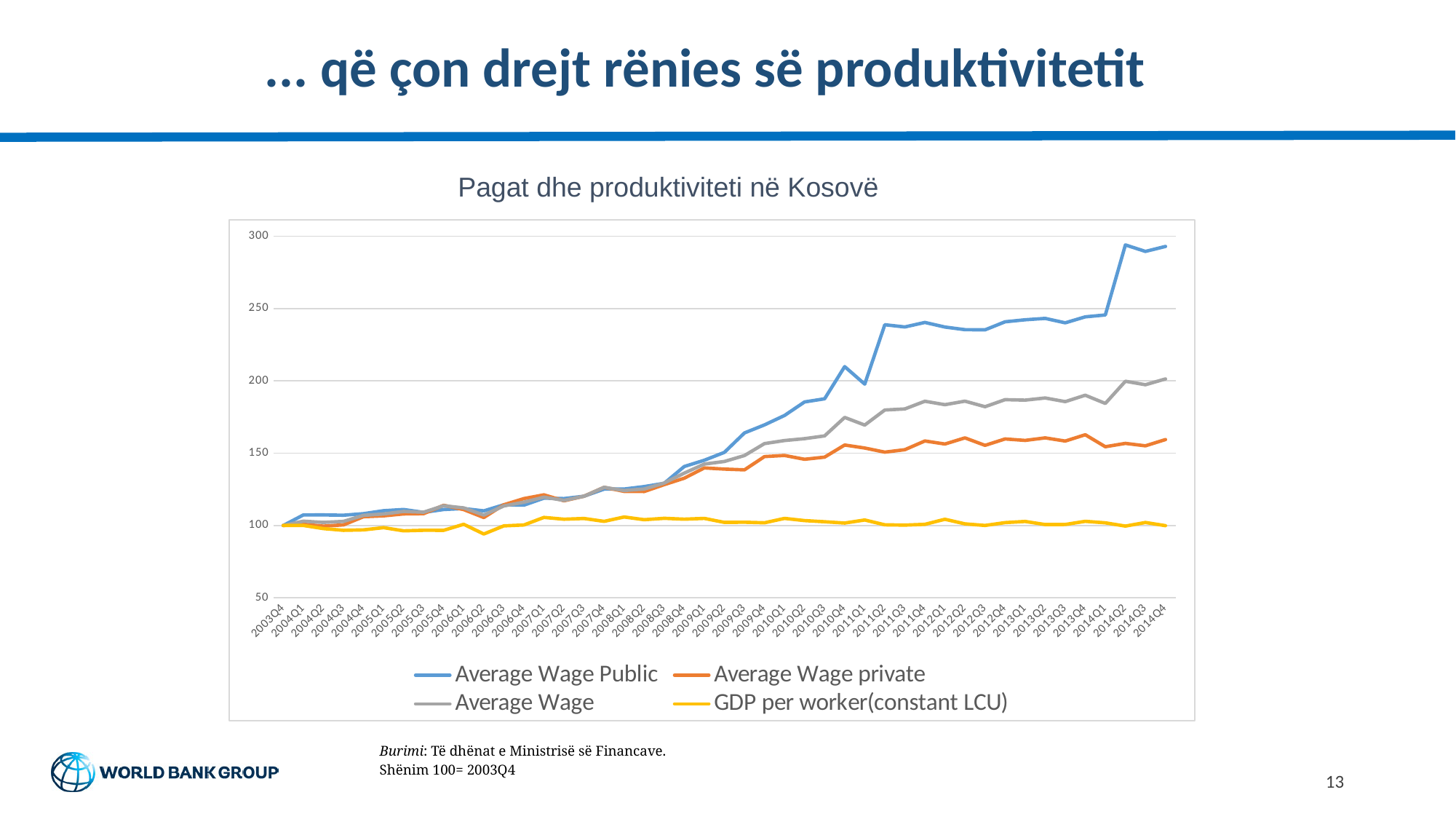
How many quarterly points are plotted along the x axis? 45 What is the title of the chart? Pagat dhe produktiviteti në Kosovë Which series is shown in yellow in the legend? GDP per worker(constant LCU) What kind of chart is shown on the slide? line chart How many series does the legend list? 4 Is the value for Average Wage private at 2014Q4 greater or less than 150? greater Which series has the highest value at 2014Q4? Average Wage Public At 2011Q2, which is larger: Average Wage Public or Average Wage private? Average Wage Public Which series has the lowest value at 2014Q4? GDP per worker(constant LCU) Is the value for GDP per worker(constant LCU) at 2014Q4 greater or less than 150? less Does the Average Wage Public series rise or fall from 2003Q4 to 2014Q4? rise Is the value for Average Wage Public at 2014Q4 greater or less than 250? greater